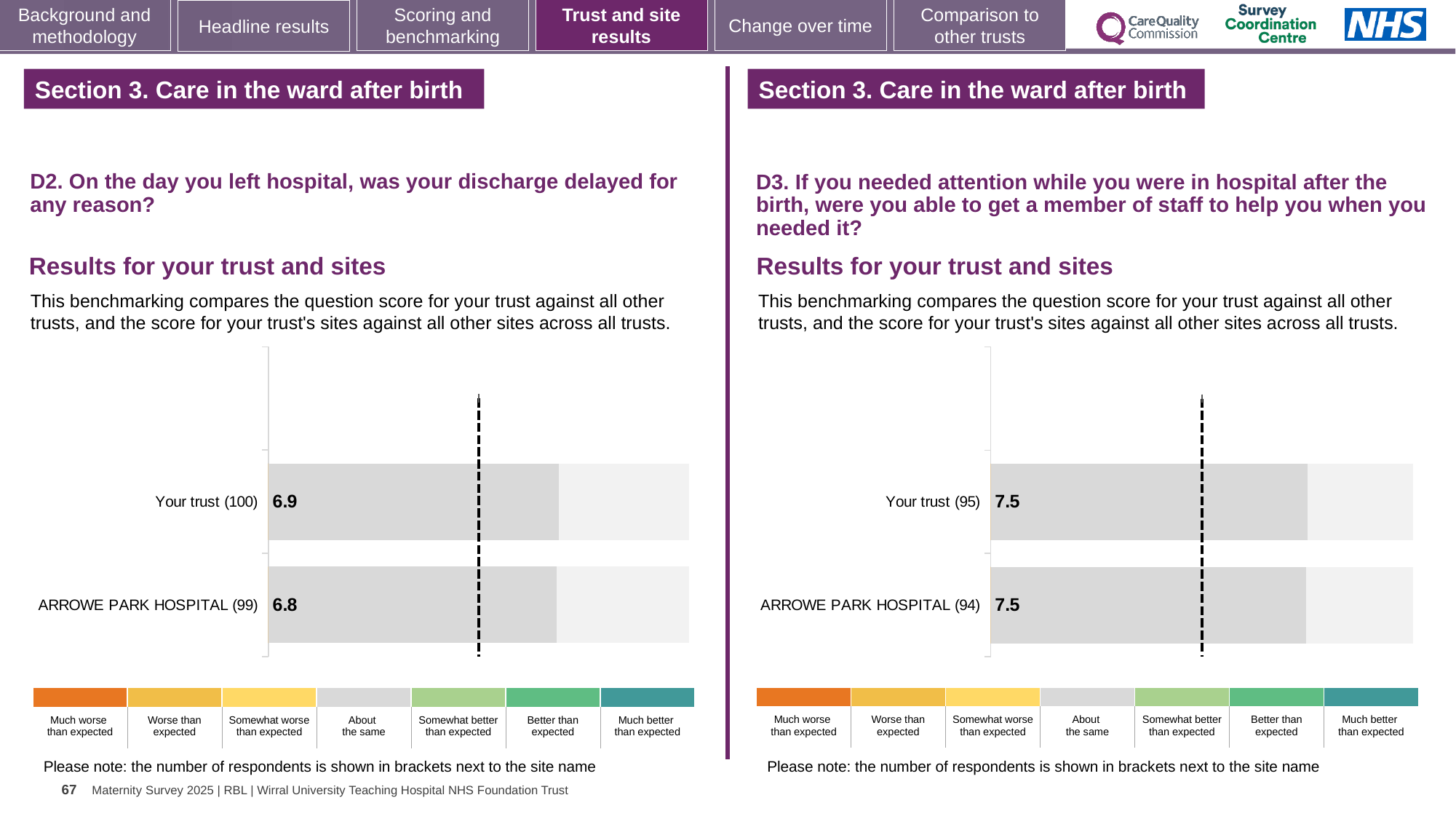
In the left chart (D2, discharge delayed), what is the score for Your trust (100)? 6.9 How many respondents are shown in brackets for Your trust in the right chart (D3)? 95 How many bars are plotted in the left chart (D2)? 2 In the right chart (D3), what is the difference between the score for Your trust and the score for ARROWE PARK HOSPITAL? 0 How many categories does the colour key below each chart list, from 'Much worse than expected' to 'Much better than expected'? 7 In the right chart (D3, able to get a member of staff to help), what is the score for Your trust (95)? 7.5 In the right chart (D3, able to get a member of staff to help), what is the score for ARROWE PARK HOSPITAL (94)? 7.5 How many bars are plotted in the right chart (D3)? 2 In the left chart (D2), which has the higher score, Your trust or ARROWE PARK HOSPITAL? Your trust What type of chart is used for the D2 results on the left? Bar chart In the left chart (D2, discharge delayed), what is the score for ARROWE PARK HOSPITAL (99)? 6.8 In the left chart (D2), what is the difference between the score for Your trust and the score for ARROWE PARK HOSPITAL? 0.1